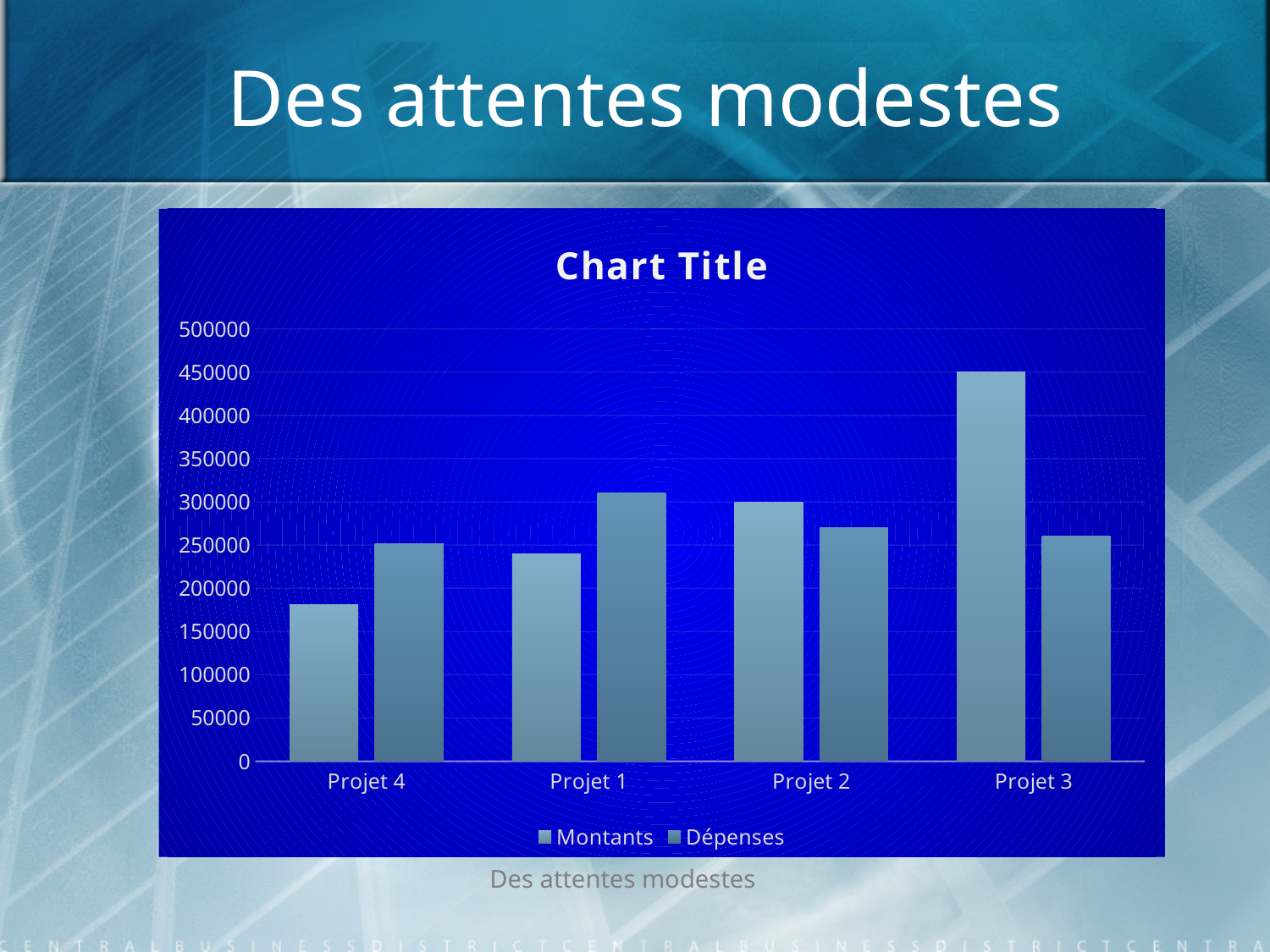
What kind of chart is shown on the slide? bar chart How many series does the legend list? 2 Which project has the highest Dépenses value? Projet 1 For Projet 2, which is larger: Montants or Dépenses? Montants How many categories are shown on the x axis? 4 Is the Dépenses value for Projet 1 greater or less than 300000? greater What is the title shown on the chart? Chart Title Is the Dépenses value for Projet 3 greater or less than 300000? less Which project has the lowest Montants value? Projet 4 Is the Montants value for Projet 4 greater or less than 200000? less What are the two series named in the legend? Montants and Dépenses Which project has the highest Montants value? Projet 3